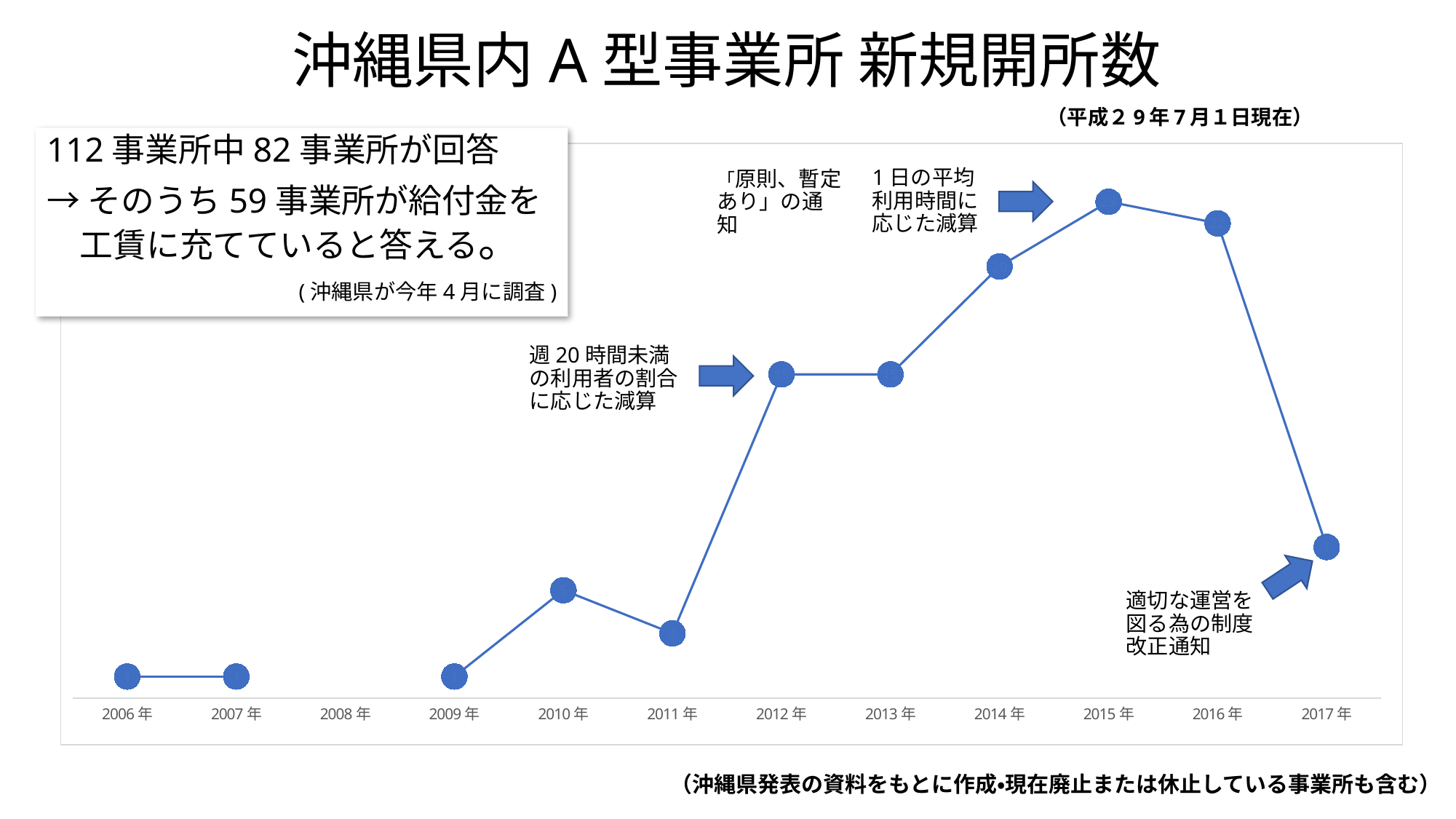
Do the values rise or fall from 2011年 to 2015年? rise Which is larger, the value for 2012年 or the value for 2011年? 2012年 What is the title of the chart? 沖縄県内A型事業所 新規開所数 What kind of chart is shown on the slide? line chart Which year on the x axis has no data point plotted? 2008年 Do the values rise or fall from 2015年 to 2017年? fall Which is larger, the value for 2014年 or the value for 2013年? 2014年 Which is larger, the value for 2009年 or the value for 2010年? 2010年 Which year has the highest value on the chart? 2015年 How many year labels are shown on the x axis? 12